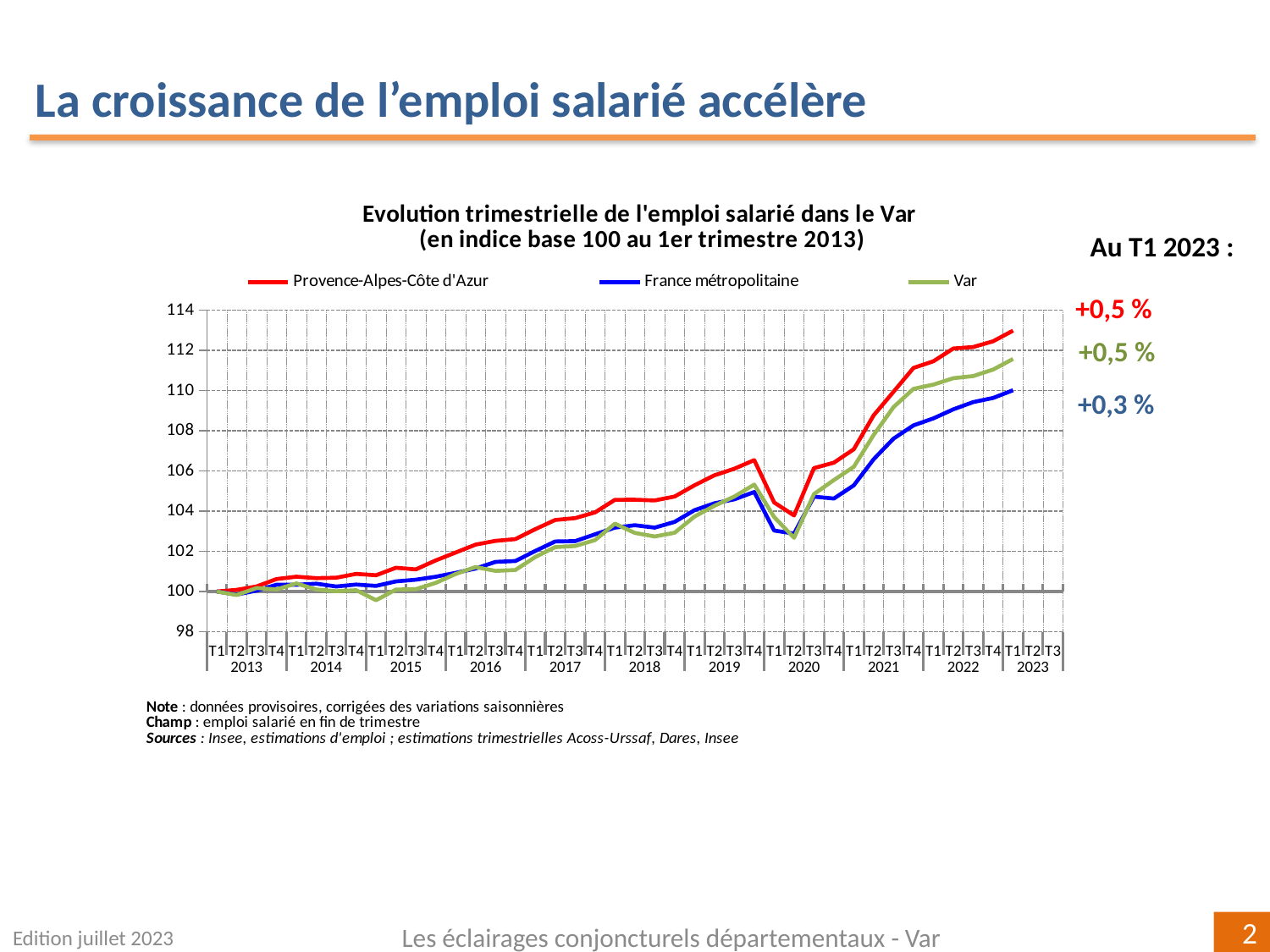
What quarterly change is shown for Provence-Alpes-Côte d'Azur at T1 2023? +0,5 % Is the value for Var at T2 2020 greater or less than 104? less How many series does the legend list? 3 What kind of chart is shown on the slide? line chart Which series has the highest index value at T1 2023? Provence-Alpes-Côte d'Azur Overall, do the index values rise or fall from T1 2013 to T1 2023? rise Which series has the lowest index value at T1 2023? France métropolitaine What quarterly change is shown for France métropolitaine at T1 2023? +0,3 % At T1 2023, which is higher: Var or France métropolitaine? Var Which series are listed in the legend? Provence-Alpes-Côte d'Azur, France métropolitaine, Var What is the title of the chart? Evolution trimestrielle de l'emploi salarié dans le Var (en indice base 100 au 1er trimestre 2013) Is the value for Provence-Alpes-Côte d'Azur at T1 2023 greater or less than 112? greater